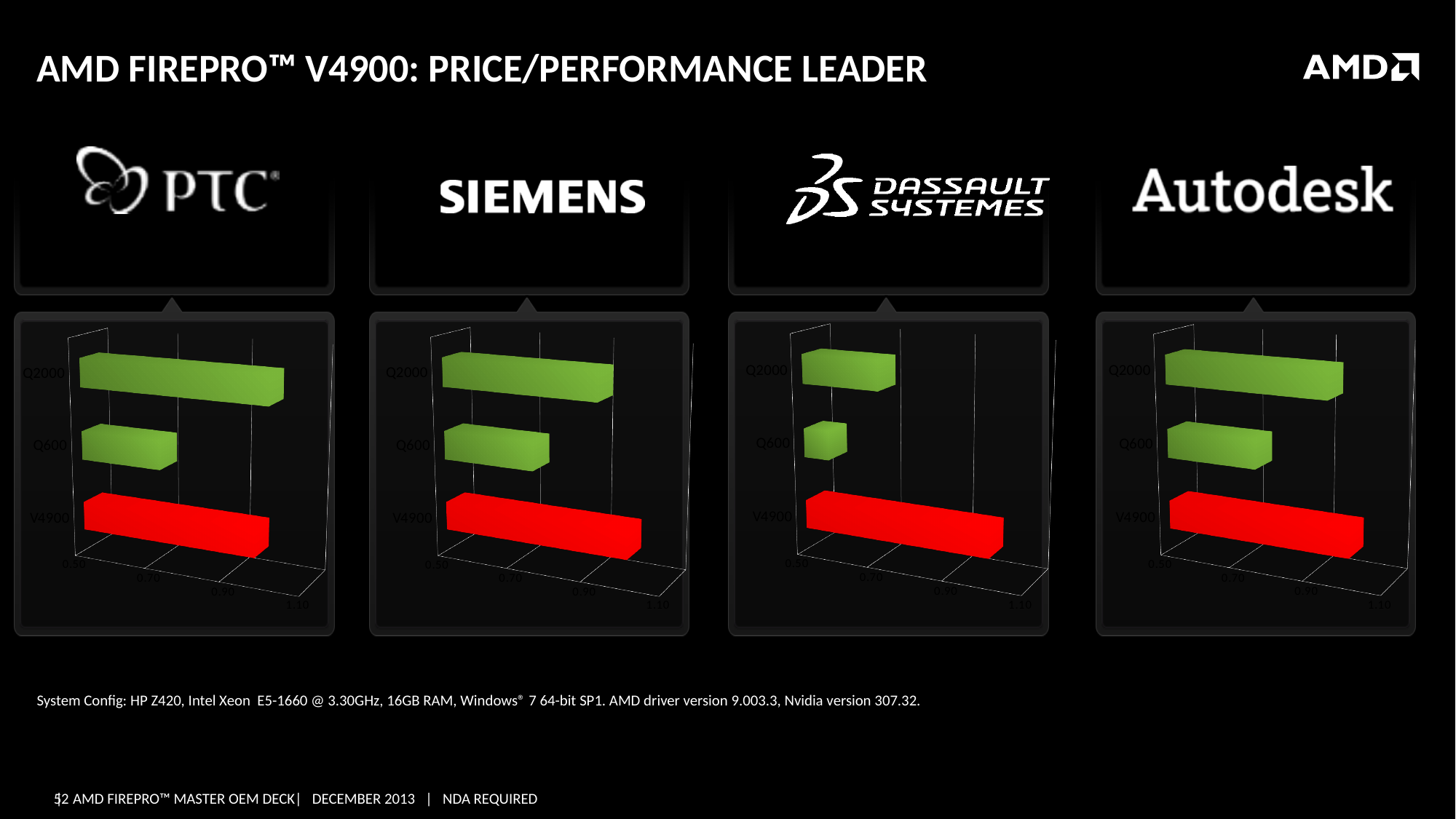
In the chart under the PTC logo, is the value for Q2000 greater or less than 0.70? greater What kind of chart is shown under the PTC logo? bar chart In the chart under the PTC logo, which category has the lowest value? Q600 In the chart under the Siemens logo, which is larger, the value for V4900 or the value for Q600? V4900 In the chart under the Dassault Systemes logo, is the value for Q600 greater or less than 0.70? less How many categories are plotted in the chart under the Siemens logo? 3 In the chart under the Dassault Systemes logo, which is larger, the value for Q2000 or the value for Q600? Q2000 In the chart under the Autodesk logo, what colour is the V4900 bar? red In the chart under the Dassault Systemes logo, which category has the highest value? V4900 In the chart under the Autodesk logo, which category has the highest value? V4900 What is the lowest axis tick value shown on the chart under the Siemens logo? 0.50 In the chart under the Dassault Systemes logo, which category has the lowest value? Q600